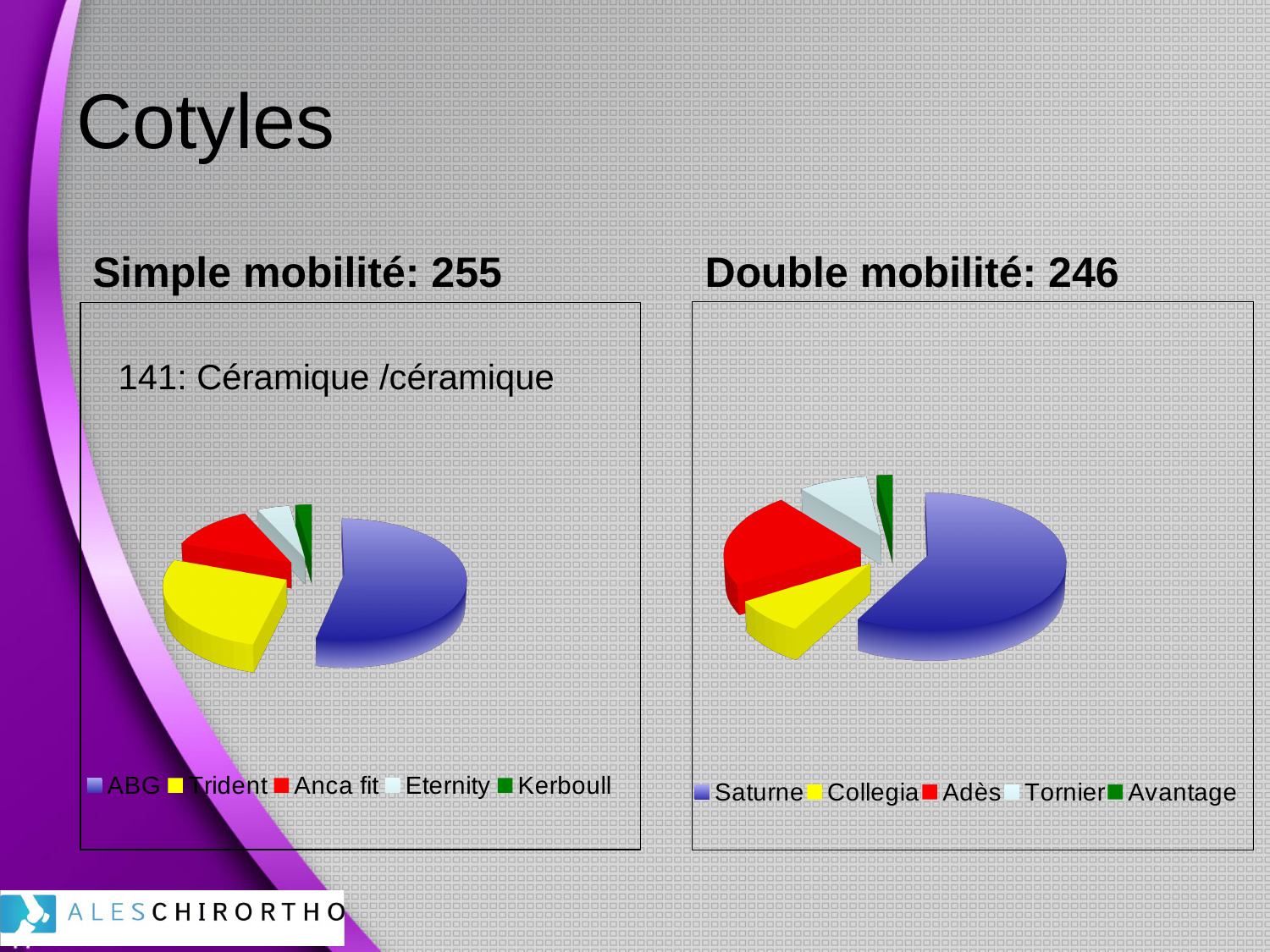
In the Simple mobilité chart, which slice is larger, ABG or Trident? ABG In the Double mobilité chart, how many categories does the legend list? 5 What kind of chart is the Simple mobilité chart on the left? pie chart In the Double mobilité chart, which category has the smallest slice? Avantage In the Double mobilité chart, which slice is larger, Saturne or Adès? Saturne What kind of chart is the Double mobilité chart on the right? pie chart In the Simple mobilité chart, what colour is the Trident slice? yellow In the Simple mobilité chart, how many categories does the legend list? 5 In the Simple mobilité chart, which category has the largest slice? ABG What total number is given in the heading above the Double mobilité chart? 246 In the Simple mobilité chart, which category has the smallest slice? Kerboull In the Double mobilité chart, which category has the largest slice? Saturne